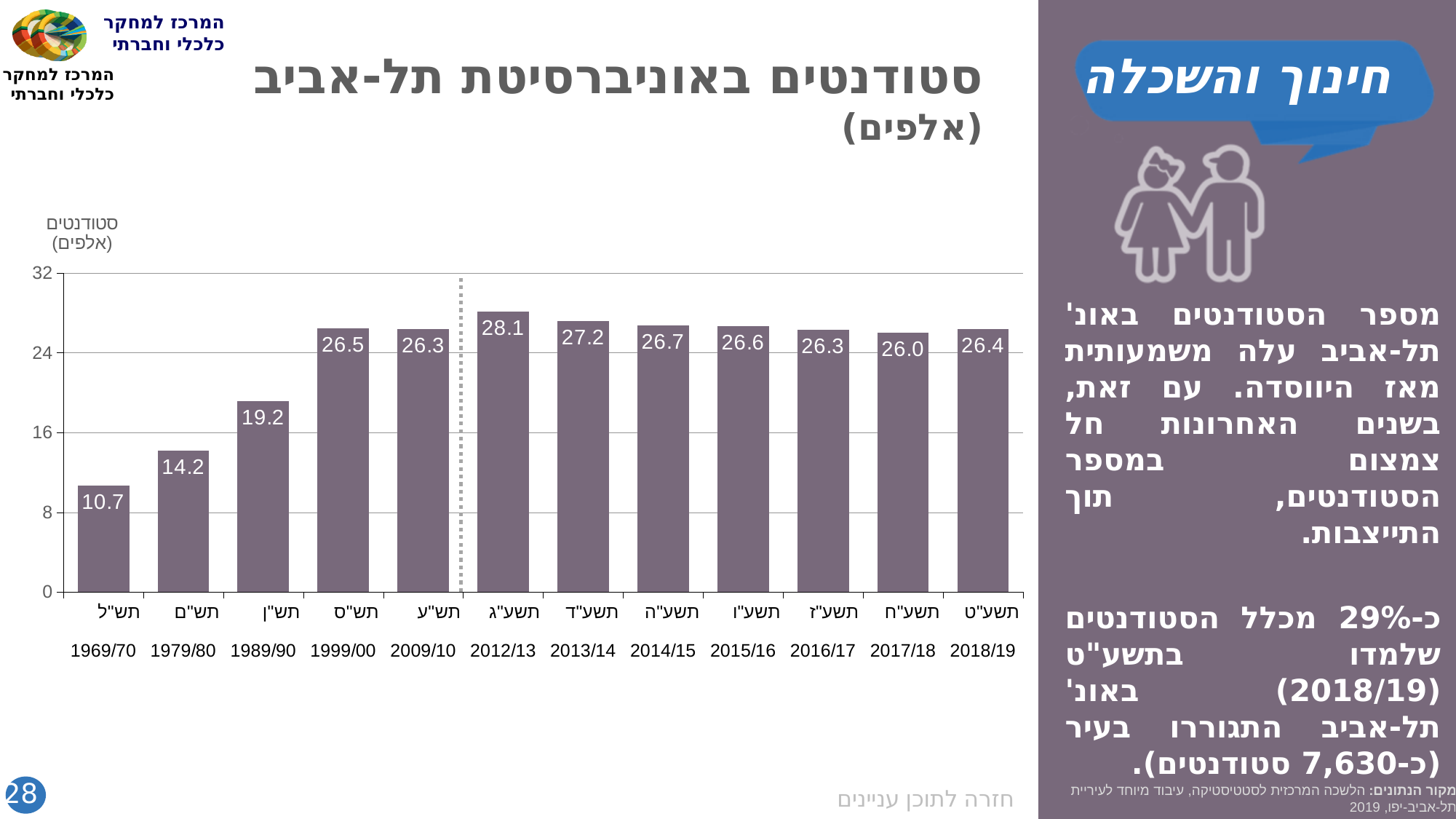
Which year has the lowest value? 1969/70 What is the value for 2018/19? 26.4 What is the value for 1989/90? 19.2 How many bars are shown in the chart? 12 What is the difference between the values for 2012/13 and 2017/18? 2.1 What is the value for 2012/13? 28.1 Which year has the highest value? 2012/13 What kind of chart is shown on the slide? bar chart Is the value for 1989/90 greater or less than 16? greater What is the difference between the values for 1979/80 and 1969/70? 3.5 What is the value for 1969/70? 10.7 Which is larger, the value for 1999/00 or the value for 2009/10? 1999/00